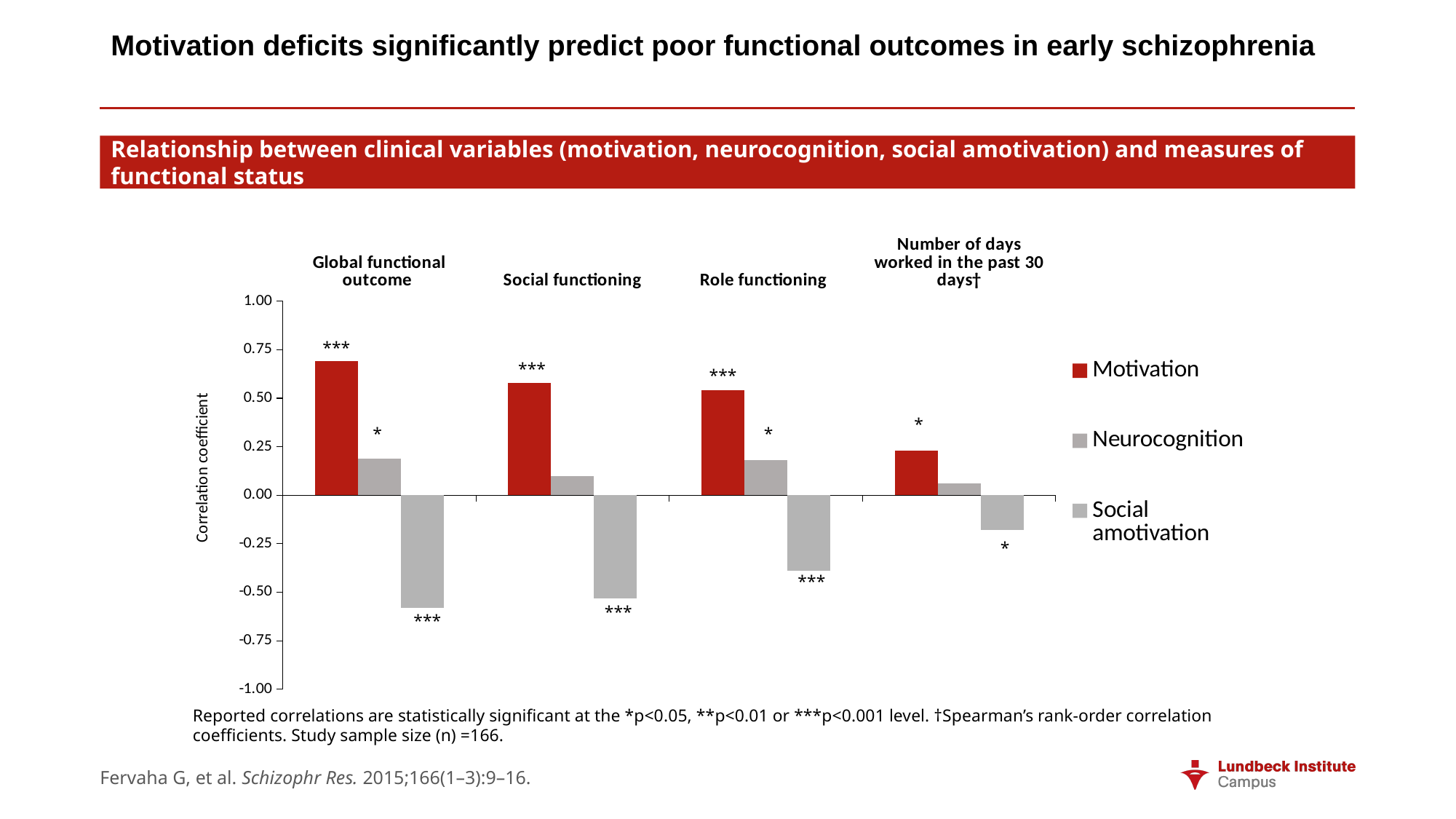
Do the Motivation bars rise or fall moving from left to right across the categories? fall Is the Social amotivation value for Role functioning greater or less than -0.50? greater What kind of chart is shown on the slide? Bar chart What is the label on the y axis? Correlation coefficient How many functional outcome categories are shown along the x axis? 4 Is the Social amotivation value for Global functional outcome greater or less than -0.50? less Is the Motivation value for Global functional outcome greater or less than 0.50? greater For Role functioning, which is larger: the Motivation value or the Neurocognition value? Motivation How many series does the legend list? 3 Which category has the highest Motivation correlation coefficient? Global functional outcome Which category has the lowest Motivation correlation coefficient? Number of days worked in the past 30 days